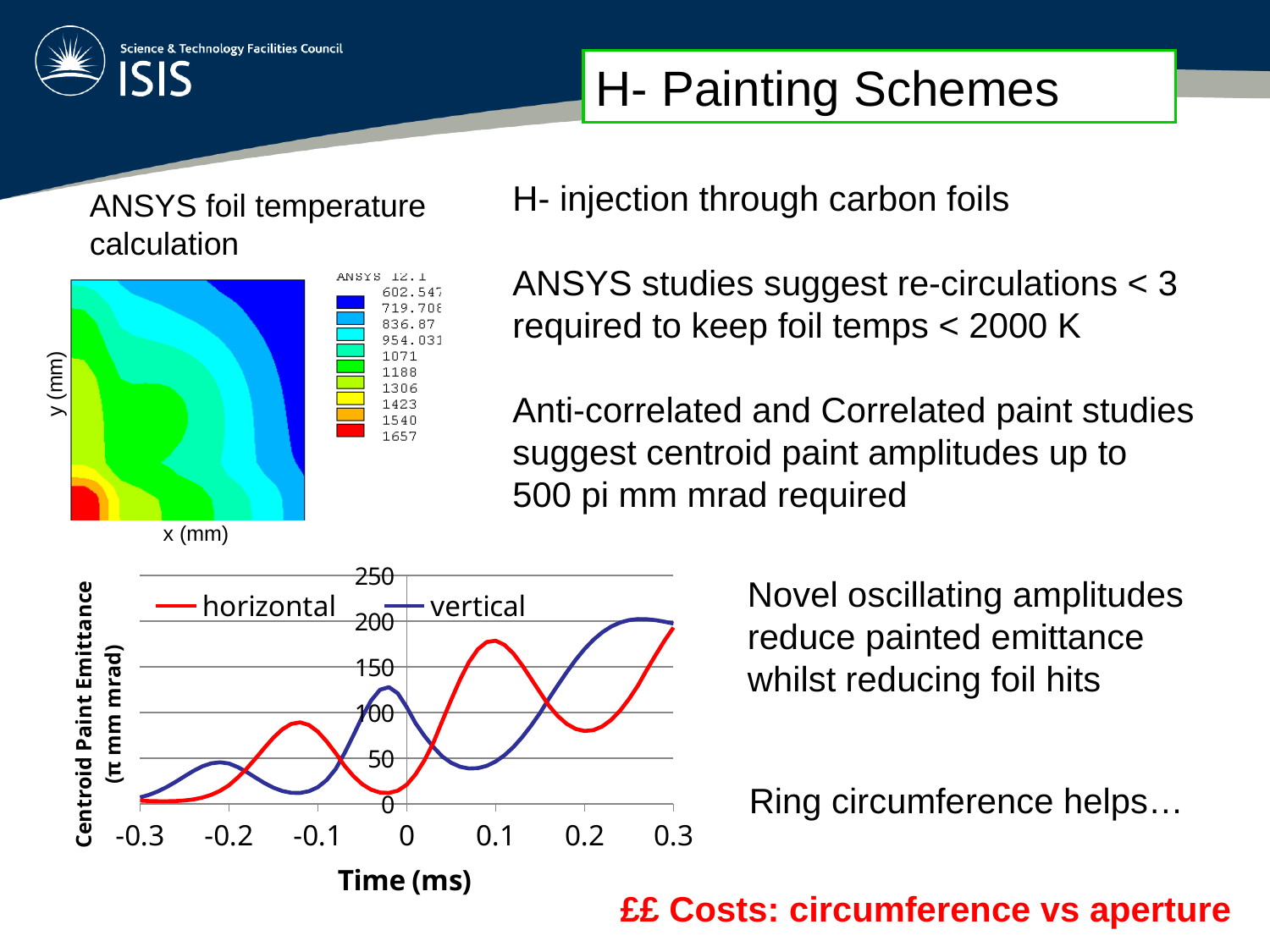
In the Centroid Paint Emittance chart, which series has the larger value at 0.1 ms, horizontal or vertical? horizontal In the Centroid Paint Emittance chart, is the horizontal value at -0.3 ms greater or less than 50? less How many tick labels are shown on the x axis of the Centroid Paint Emittance chart? 7 In the Centroid Paint Emittance chart, is the vertical value at -0.1 ms greater or less than 50? less In the Centroid Paint Emittance chart, is the horizontal value at 0.1 ms greater or less than 150? greater In the Centroid Paint Emittance chart, do the peak amplitudes of the oscillations rise or fall as time increases from -0.3 to 0.3 ms? rise What is the x-axis title of the Centroid Paint Emittance chart? Time (ms) What are the two series named in the legend of the Centroid Paint Emittance chart? horizontal and vertical In the Centroid Paint Emittance chart, which series has the larger value at 0.2 ms, horizontal or vertical? vertical What kind of chart is the Centroid Paint Emittance vs Time chart? line chart How many series does the legend of the Centroid Paint Emittance chart list? 2